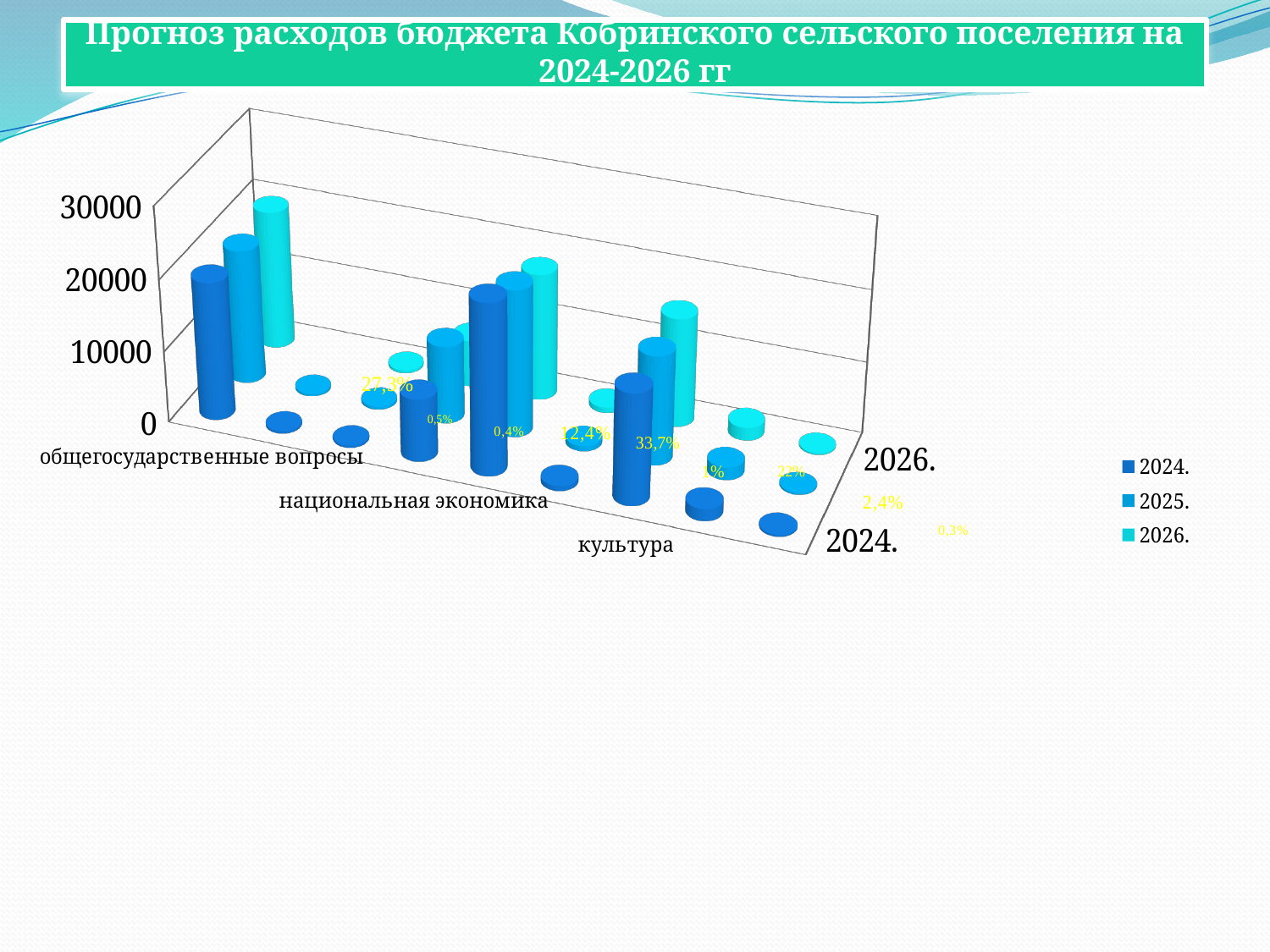
Is the 2024 value for культура greater or less than 20000? less What are the series listed in the legend? 2024., 2025., 2026. How many series does the legend list? 3 Is the 2024 value for общегосударственные вопросы greater or less than 10000? greater What is the title of the chart? Прогноз расходов бюджета Кобринского сельского поселения на 2024-2026 гг What kind of chart is shown on the slide? bar chart Is the 2026 value for национальная экономика greater or less than 10000? less Among the labelled categories, which has the highest 2024 value? общегосударственные вопросы